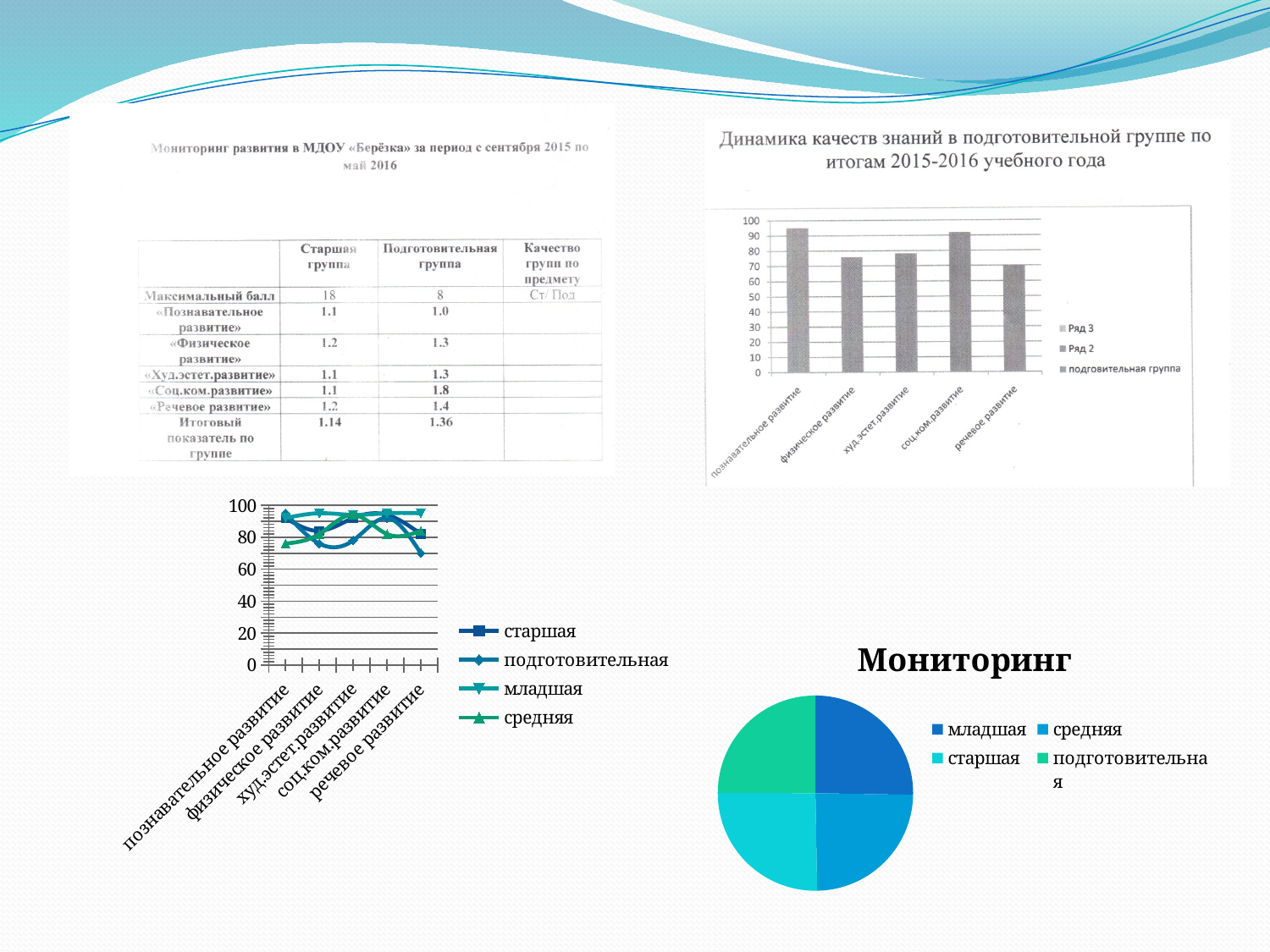
In the bar chart at the top right, is the value for речевое развитие greater or less than 80? less In the pie chart titled "Мониторинг", how many slices are there? 4 In the bar chart at the top right, which is larger: the value for соц.ком.развитие or the value for речевое развитие? соц.ком.развитие What type of chart is the chart at the bottom left of the slide? line chart In the bar chart at the top right, is the value for познавательное развитие greater or less than 90? greater What type of chart is the chart titled "Мониторинг"? pie chart In the line chart at the bottom left, how many series does the legend list? 4 What type of chart is the chart titled "Динамика качеств знаний в подготовительной группе по итогам 2015-2016 учебного года"? bar chart In the bar chart at the top right, which category has the lowest bar? речевое развитие In the bar chart at the top right, is the value for физическое развитие greater or less than 80? less In the bar chart at the top right, how many entries does the legend list? 3 In the bar chart at the top right, how many categories are shown on the x axis? 5